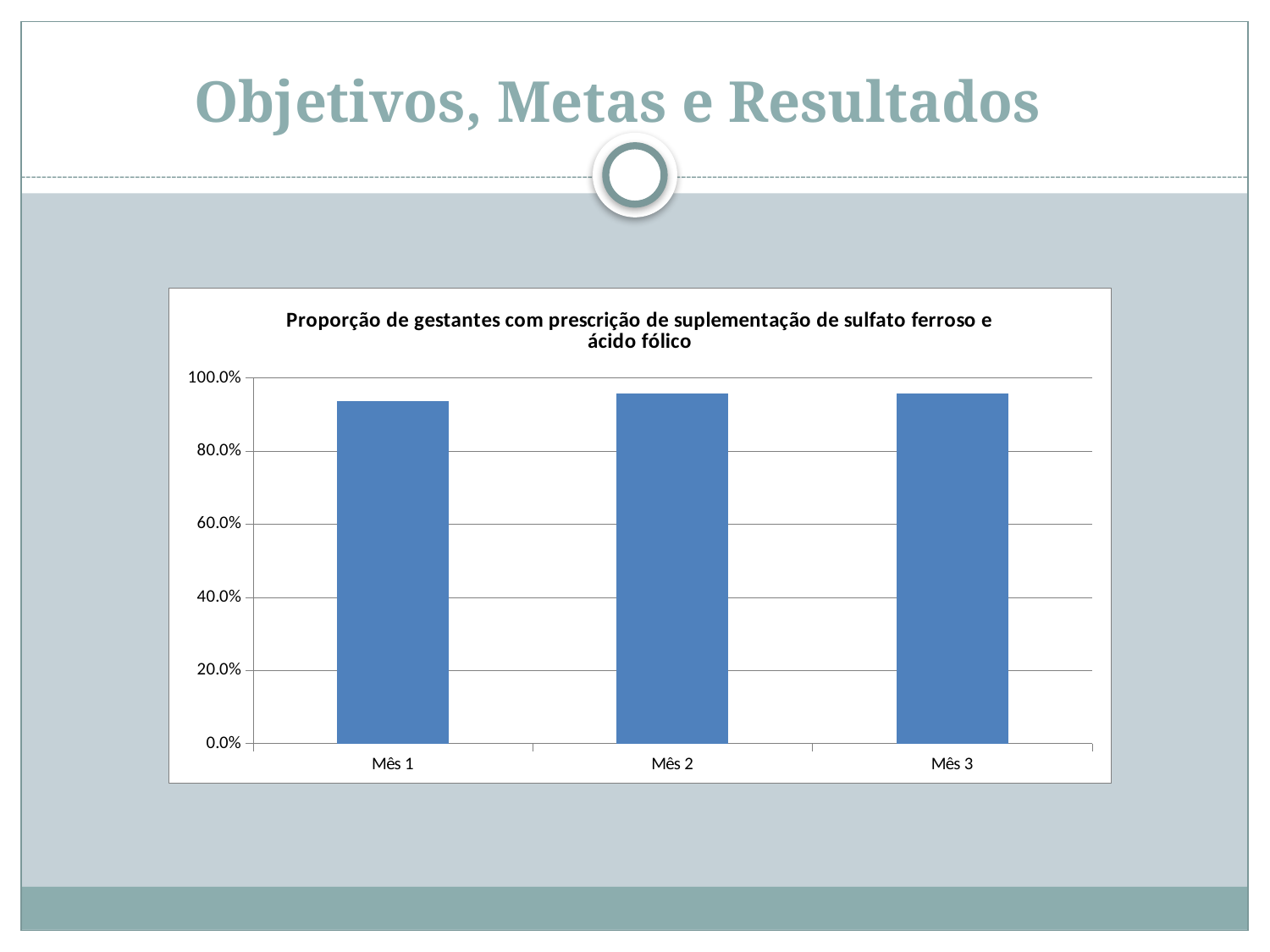
What is the label of the first category on the x axis? Mês 1 What is the highest value shown on the y axis? 100.0% What is the title of the chart? Proporção de gestantes com prescrição de suplementação de sulfato ferroso e ácido fólico Is the value for Mês 2 greater or less than 60.0%? greater Is the value for Mês 1 greater or less than 100.0%? less Is the value for Mês 3 greater or less than 80.0%? greater What kind of chart is shown on the slide? bar chart How many categories (months) are plotted on the chart? 3